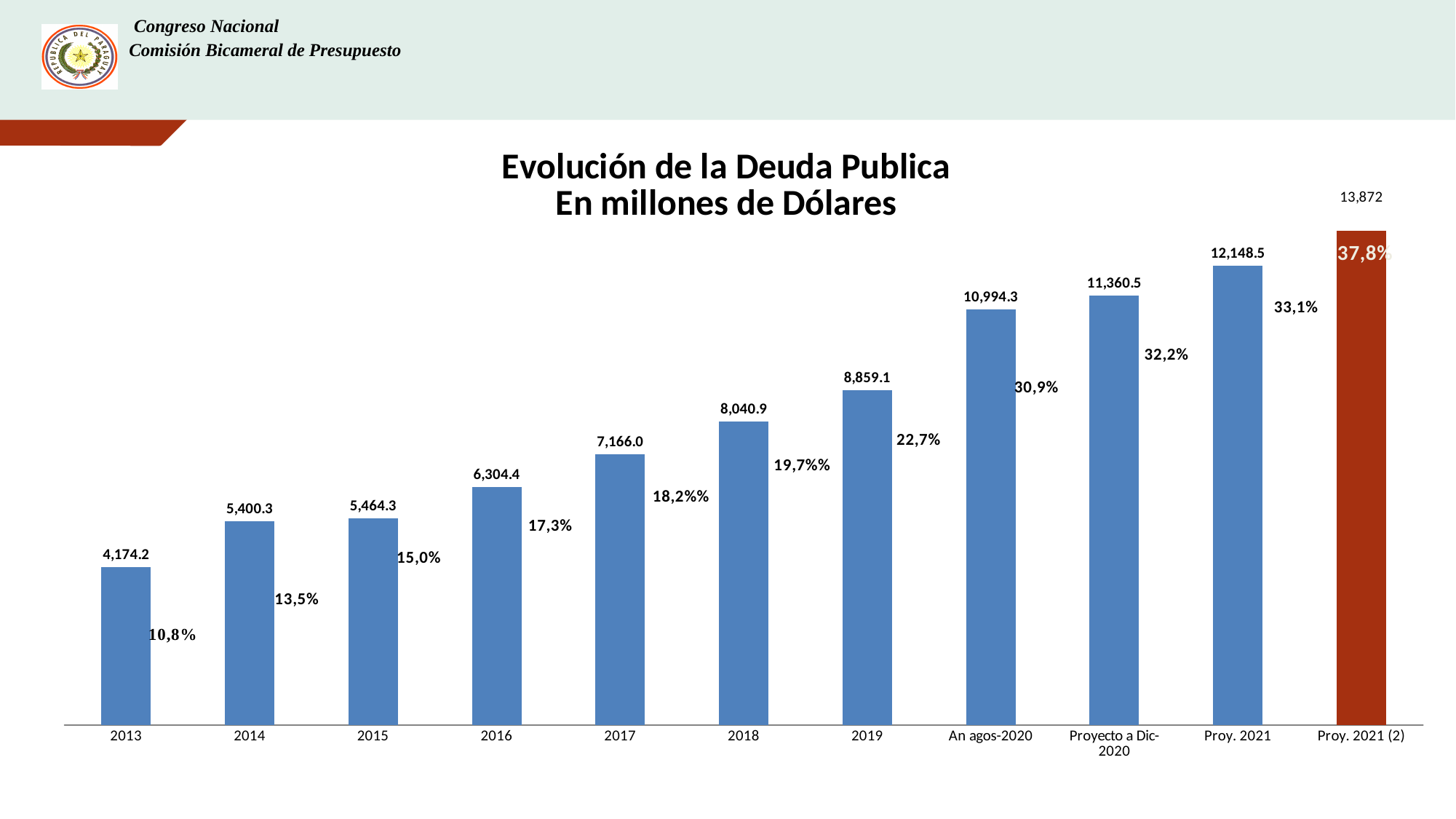
What is the value for An agos-2020? 10,994.3 Which category has the highest value? Proy. 2021 (2) What is the value for Proy. 2021 (2)? 13,872 Which is larger, the value for Proy. 2021 or the value for Proyecto a Dic-2020? Proy. 2021 Which category has the lowest value? 2013 How many bars are plotted in the chart? 11 What kind of chart is shown on the slide? Bar chart What is the difference between the values for 2014 and 2013? 1,226.1 Do the values rise or fall from 2013 to Proy. 2021 (2)? Rise What is the difference between the values for 2019 and 2018? 818.2 What is the value for 2013? 4,174.2 What is the value for 2017? 7,166.0